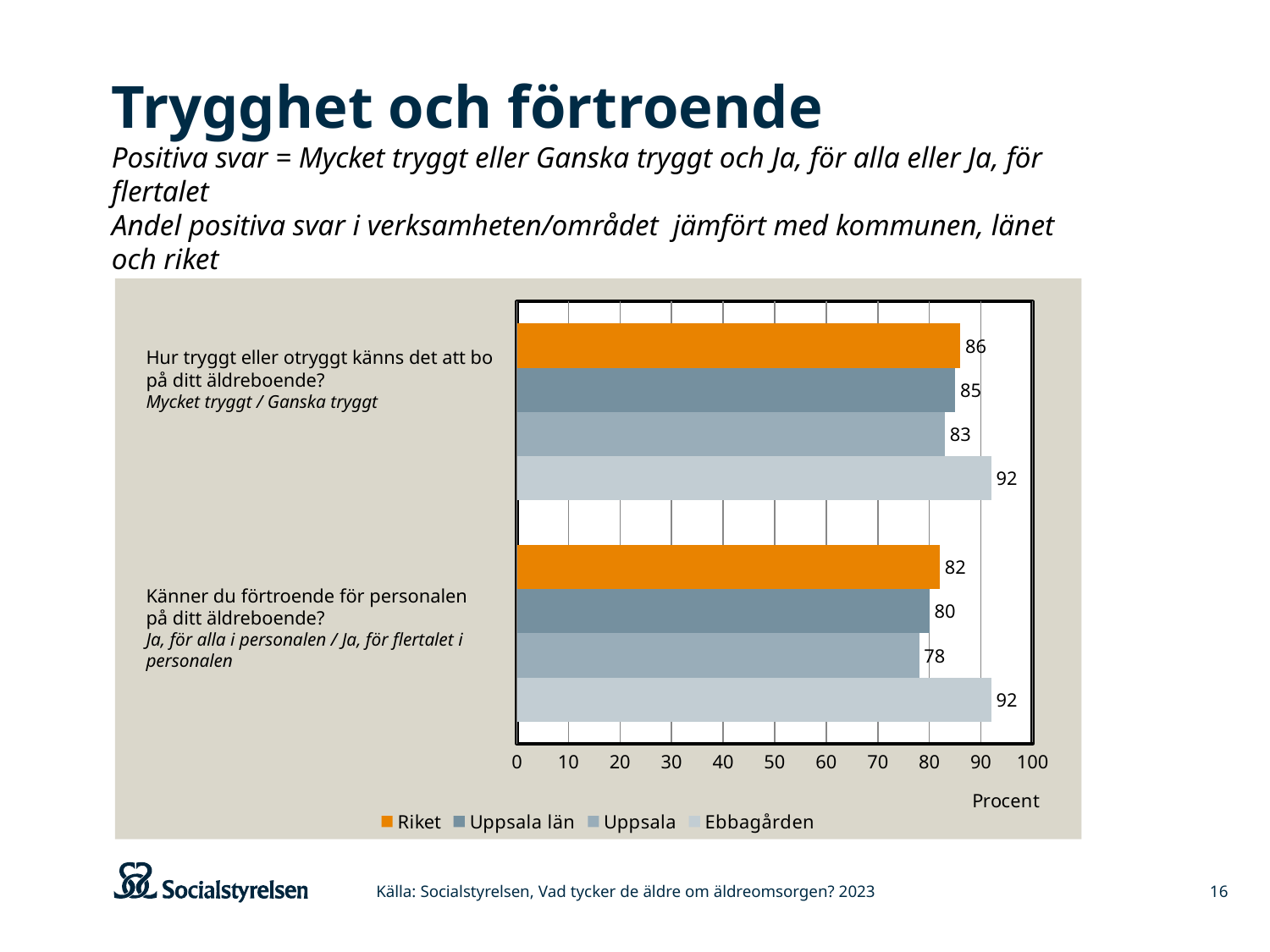
What kind of chart is shown on the slide? Bar chart What is the difference between Riket and Uppsala län on the question "Hur tryggt eller otryggt känns det att bo på ditt äldreboende?"? 1 What is the value for Ebbagården on the question "Hur tryggt eller otryggt känns det att bo på ditt äldreboende?"? 92 Which series has the highest value on the question "Känner du förtroende för personalen på ditt äldreboende?"? Ebbagården What is the value for Uppsala län on the question "Hur tryggt eller otryggt känns det att bo på ditt äldreboende?"? 85 What is the difference between Ebbagården and Uppsala on the question "Känner du förtroende för personalen på ditt äldreboende?"? 14 What is the value for Riket on the question "Känner du förtroende för personalen på ditt äldreboende?"? 82 How many series does the legend list? 4 What unit is shown on the x axis of the chart? Procent What is the value for Uppsala on the question "Känner du förtroende för personalen på ditt äldreboende?"? 78 Which series has the lowest value on the question "Hur tryggt eller otryggt känns det att bo på ditt äldreboende?"? Uppsala Which is larger: Riket on the trygghet question or Riket on the förtroende question? Riket on the trygghet question